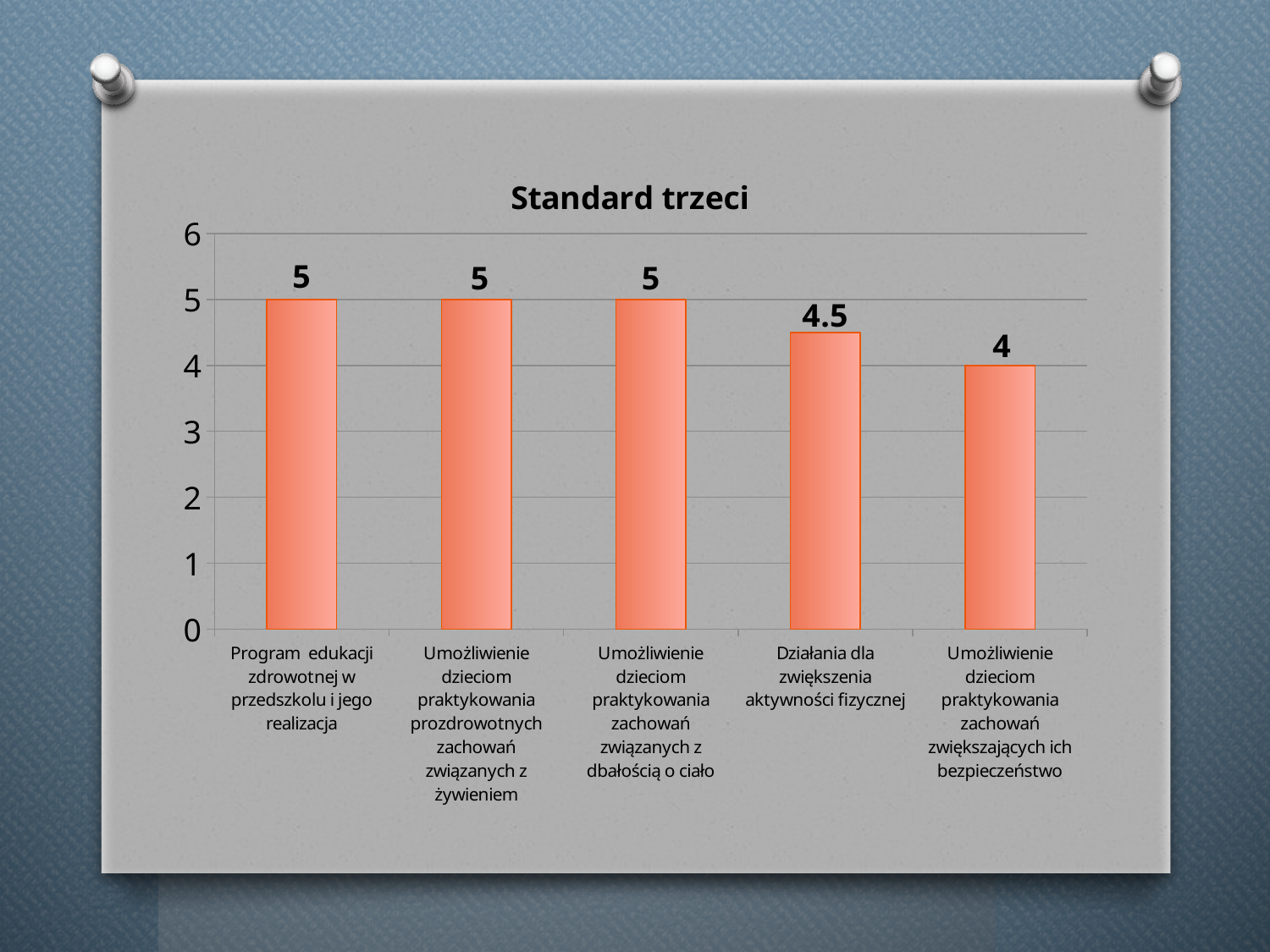
Which category has the lowest value? Umożliwienie dzieciom praktykowania zachowań zwiększających ich bezpieczeństwo What is the title of the chart? Standard trzeci What is the difference between the value for "Działania dla zwiększenia aktywności fizycznej" and the value for "Umożliwienie dzieciom praktykowania zachowań zwiększających ich bezpieczeństwo"? 0.5 What is the value for "Umożliwienie dzieciom praktykowania zachowań zwiększających ich bezpieczeństwo"? 4 What is the value for "Działania dla zwiększenia aktywności fizycznej"? 4.5 What is the value for "Program edukacji zdrowotnej w przedszkolu i jego realizacja"? 5 What is the maximum value shown on the vertical axis? 6 What is the difference between the value for "Program edukacji zdrowotnej w przedszkolu i jego realizacja" and the value for "Umożliwienie dzieciom praktykowania zachowań zwiększających ich bezpieczeństwo"? 1 Do the values generally rise or fall from left to right across the categories? fall How many categories are shown in the chart? 5 Which is larger: the value for "Umożliwienie dzieciom praktykowania zachowań związanych z dbałością o ciało" or the value for "Działania dla zwiększenia aktywności fizycznej"? Umożliwienie dzieciom praktykowania zachowań związanych z dbałością o ciało What type of chart is shown on the slide? bar chart